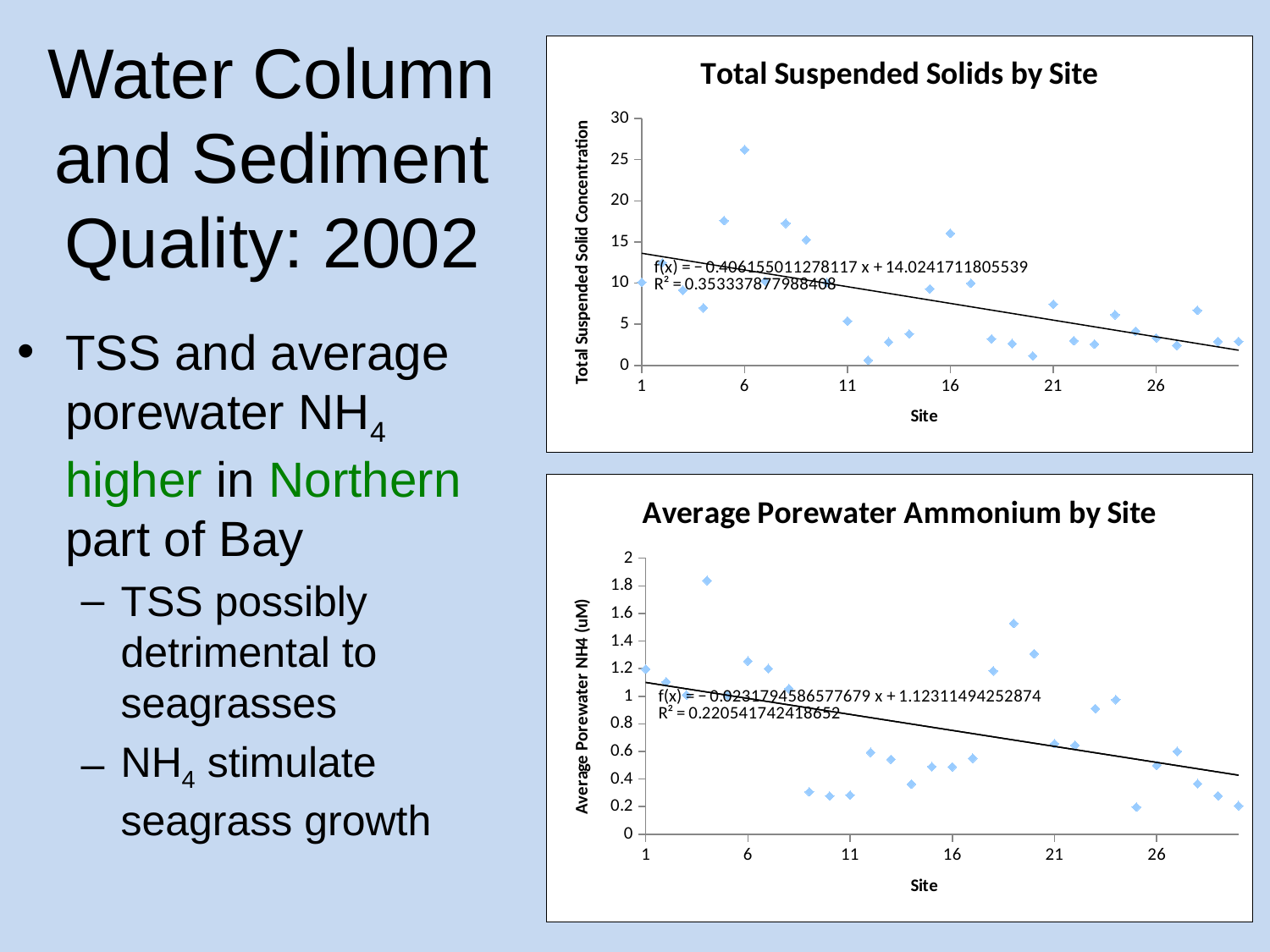
In the "Total Suspended Solids by Site" chart, which site has the highest total suspended solid concentration? Site 6 What R² value is printed on the "Total Suspended Solids by Site" chart? 0.353337877988408 In the "Average Porewater Ammonium by Site" chart, which site has the highest average porewater NH4? Site 4 In the "Total Suspended Solids by Site" chart, do the values generally rise or fall as the site number increases? fall In the "Average Porewater Ammonium by Site" chart, is the value for site 25 greater or less than 0.4? less What is the y-axis label of the "Average Porewater Ammonium by Site" chart? Average Porewater NH4 (uM) What kind of chart is the "Total Suspended Solids by Site" chart? scatter chart In the "Total Suspended Solids by Site" chart, is the value for site 12 greater or less than 5? less In the "Average Porewater Ammonium by Site" chart, is the value for site 4 greater or less than 1.6? greater In the "Average Porewater Ammonium by Site" chart, does the trend line rise or fall from left to right? fall In the "Total Suspended Solids by Site" chart, which has the larger value, site 6 or site 12? Site 6